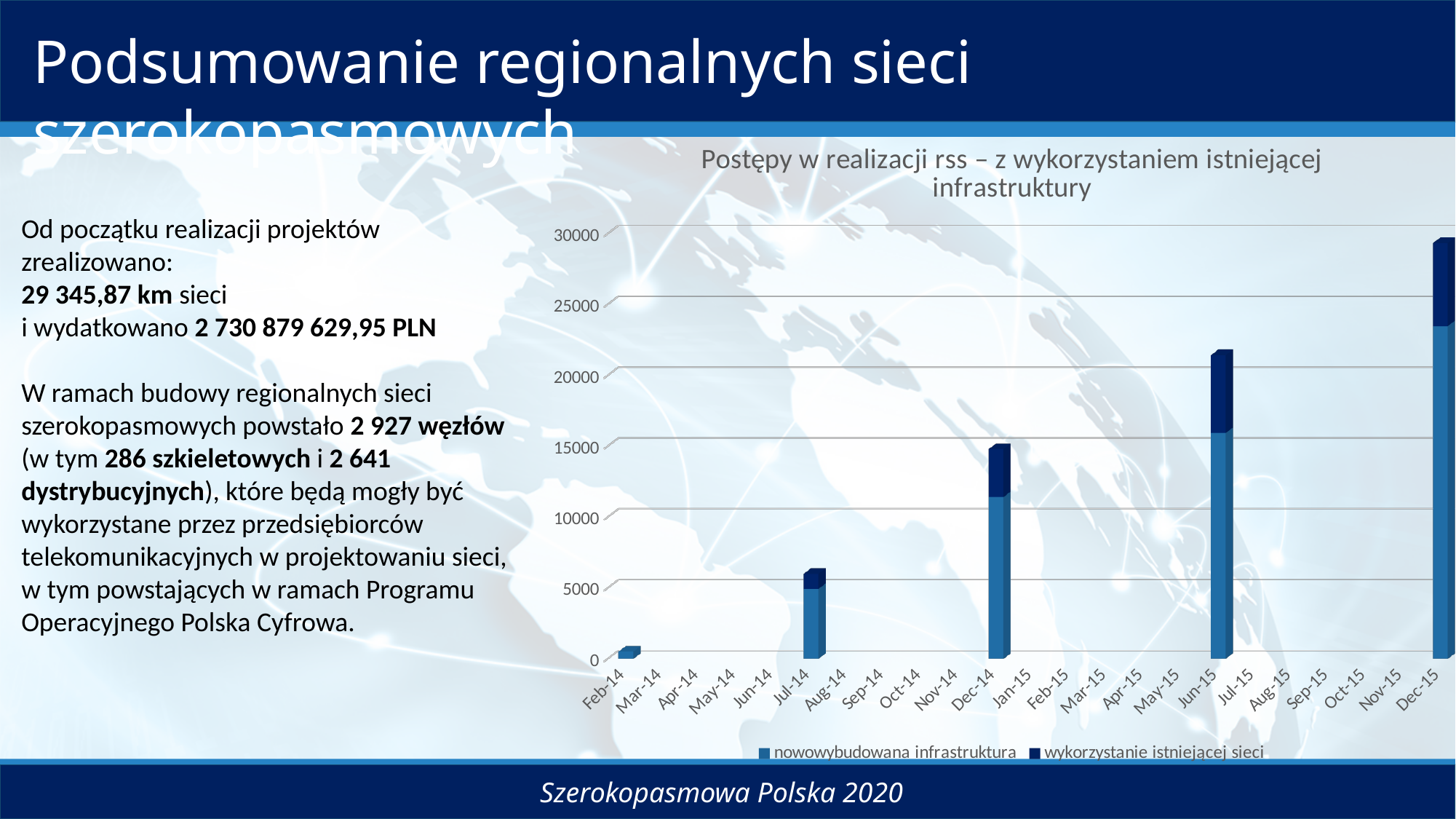
Which has the larger total bar, Jun-15 or Dec-14? Jun-15 Which month has the tallest bar? Dec-15 Is the total bar value for Dec-14 greater or less than 10000? greater Is the total bar value for Dec-15 greater or less than 25000? greater Is the total bar value for Jul-14 greater or less than 10000? less How many month categories are shown on the x axis? 23 What are the two series named in the legend? nowowybudowana infrastruktura; wykorzystanie istniejącej sieci What is the title of the chart? Postępy w realizacji rss – z wykorzystaniem istniejącej infrastruktury How many series does the chart legend list? 2 Among the months with a visible bar, which has the smallest total? Feb-14 What kind of chart is shown on the slide? bar chart